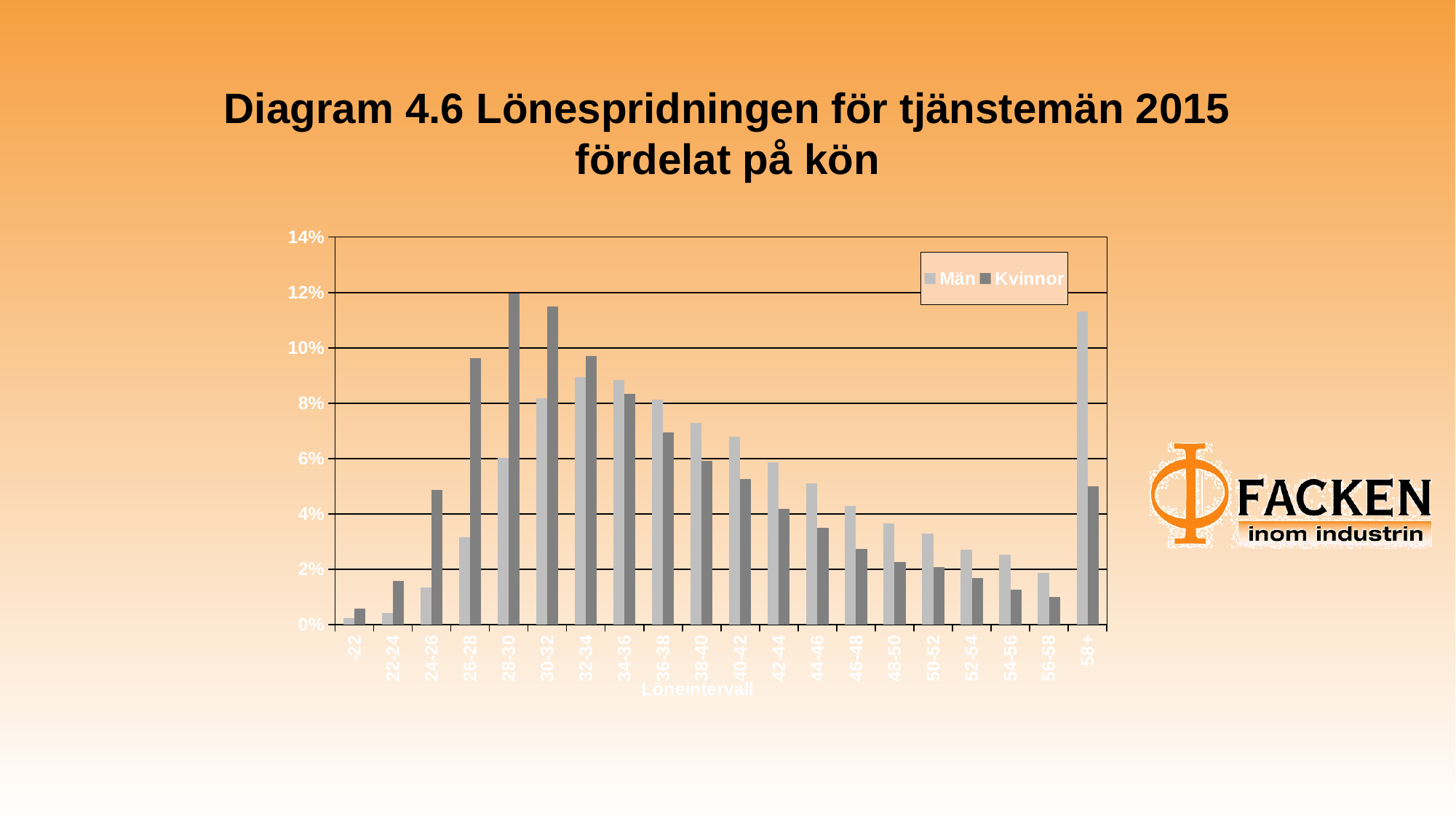
Which salary interval has the lowest value for Kvinnor? -22 How many salary interval categories are shown on the x axis? 20 Do the values for Kvinnor rise or fall from the 30-32 interval to the 56-58 interval? fall What kind of chart is shown on the slide? bar chart Which salary interval has the lowest value for Män? -22 In the 58+ interval, which series has the larger value, Män or Kvinnor? Män Is the value for Män in the 58+ interval greater or less than 10%? greater In the 26-28 interval, which series has the larger value, Män or Kvinnor? Kvinnor Is the value for Kvinnor in the 36-38 interval greater or less than 8%? less How many series does the legend list? 2 What is the label of the x axis? Löneintervall Which salary interval has the highest value for Män? 58+